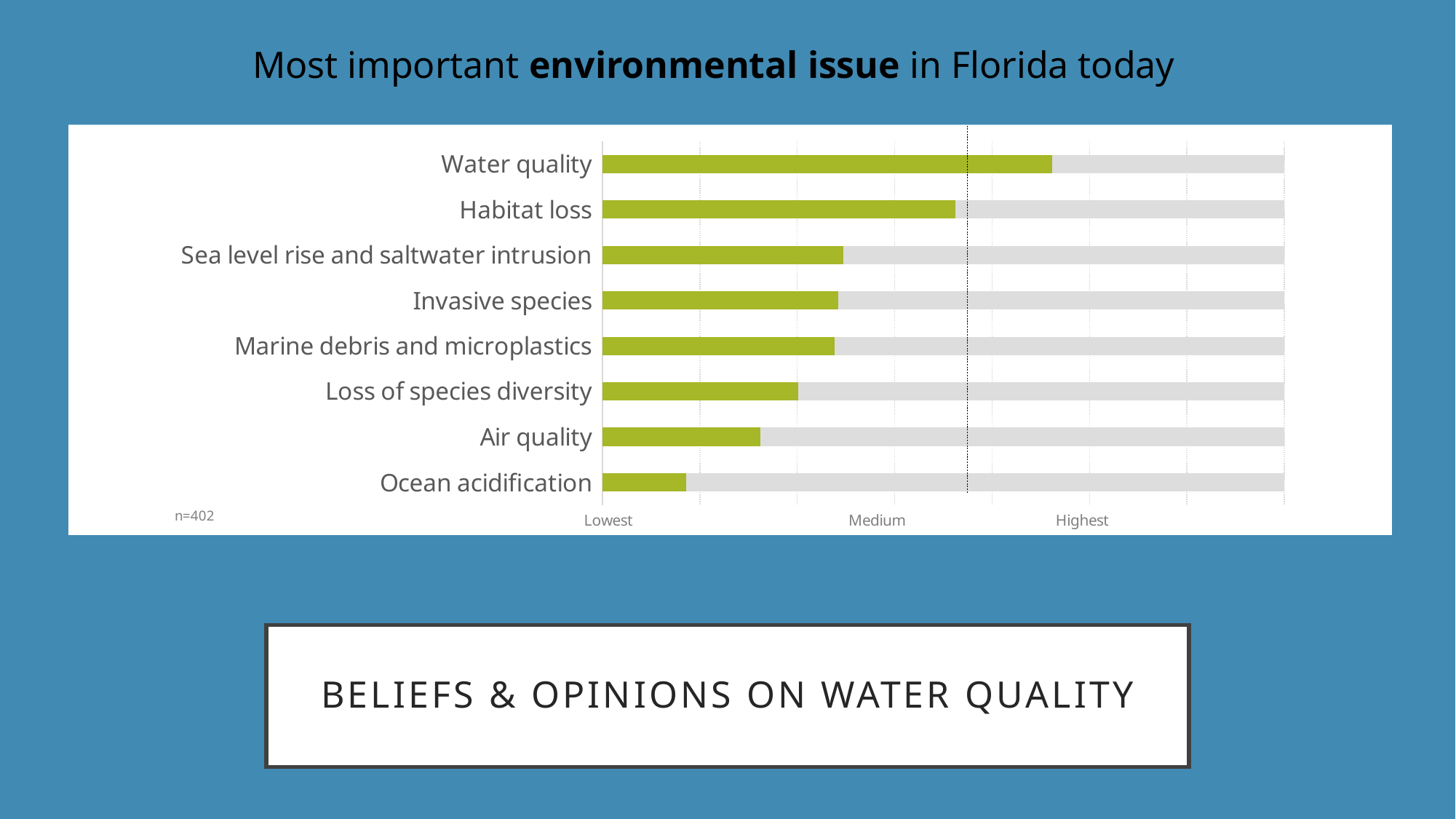
Which is rated higher, Water quality or Habitat loss? Water quality Is the bar for Air quality above or below the Medium mark on the axis? below Which environmental issue has the highest rating in the chart? Water quality What kind of chart is shown on the slide? Bar chart What are the three labels shown on the horizontal axis of the chart? Lowest, Medium, Highest What sample size is noted on the chart? n=402 Which is rated higher, Air quality or Loss of species diversity? Loss of species diversity Which environmental issue has the lowest rating in the chart? Ocean acidification Which is rated higher, Ocean acidification or Air quality? Air quality Is the bar for Ocean acidification above or below the Medium mark on the axis? below Is the bar for Water quality above or below the Medium mark on the axis? above How many environmental issues are listed in the chart? 8